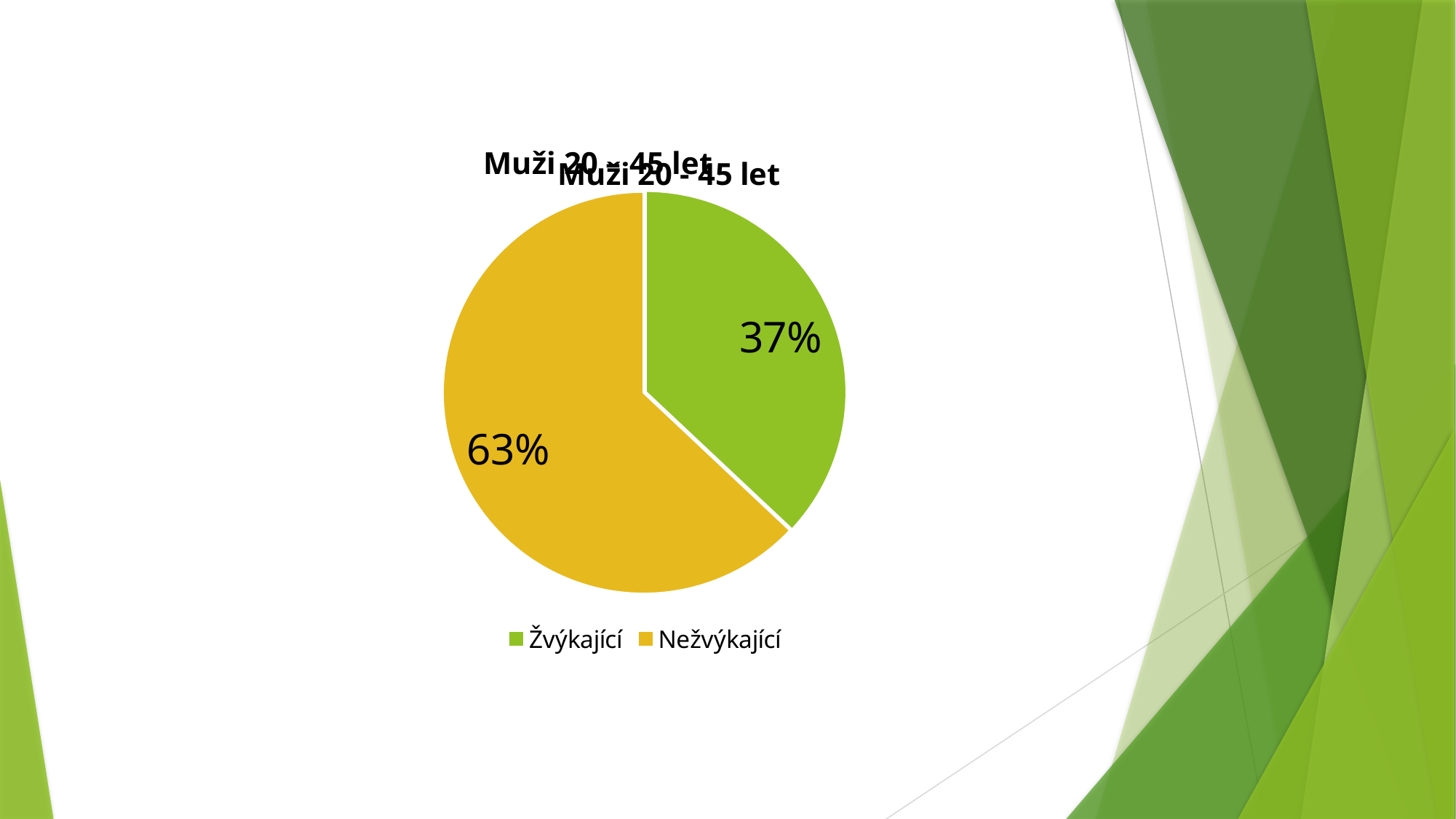
Which is larger, Žvýkající or Nežvýkající? Nežvýkající What kind of chart is shown on the slide? pie chart How many entries does the legend list? 2 How many slices does the pie chart have? 2 What share of the pie does Nežvýkající represent? 63% What is the title of the chart? Muži 20 - 45 let What colour is the Nežvýkající slice? yellow What is the difference in percentage points between Nežvýkající and Žvýkající? 26 What share of the pie does Žvýkající represent? 37% Which slice is the smallest? Žvýkající Which slice is the largest? Nežvýkající